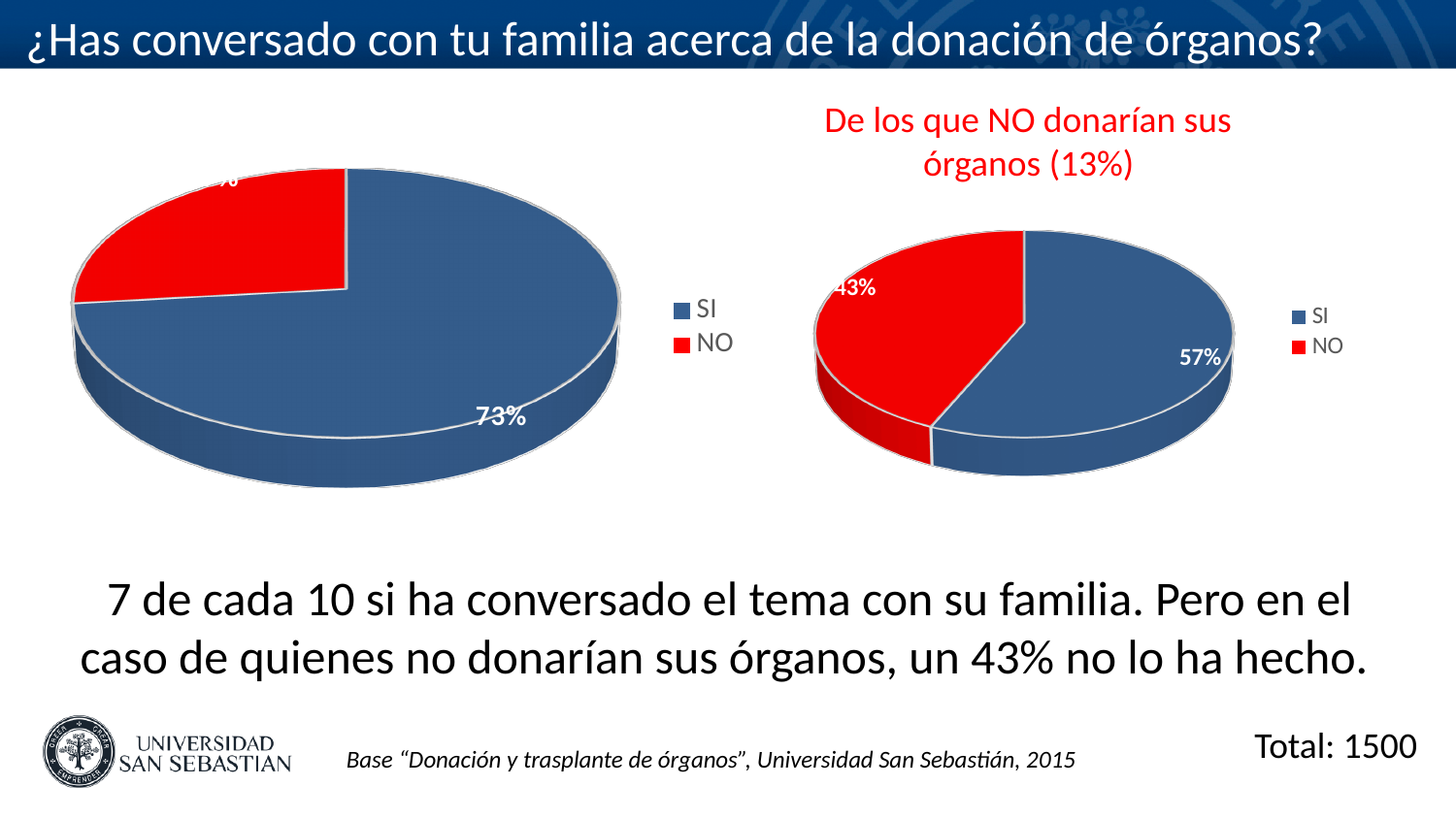
How many slices does the chart on the right of the slide have? 2 In the chart titled 'De los que NO donarían sus órganos (13%)', what percentage is shown for SI? 57% In the chart titled 'De los que NO donarían sus órganos (13%)', which slice is larger, SI or NO? SI What is the title of the chart on the right of the slide? De los que NO donarían sus órganos (13%) In the chart on the left of the slide, which category has the largest slice? SI In the chart titled 'De los que NO donarían sus órganos (13%)', which category has the smallest slice? NO In the chart on the left of the slide, what percentage is shown for SI? 73% In the chart on the right of the slide, what colour represents NO? red In the chart titled 'De los que NO donarían sus órganos (13%)', what percentage is shown for NO? 43% In the chart titled 'De los que NO donarían sus órganos (13%)', what is the difference between the SI and NO percentages? 14% How many entries does the legend of the chart on the left of the slide list? 2 What kind of chart is the chart on the left of the slide? pie chart